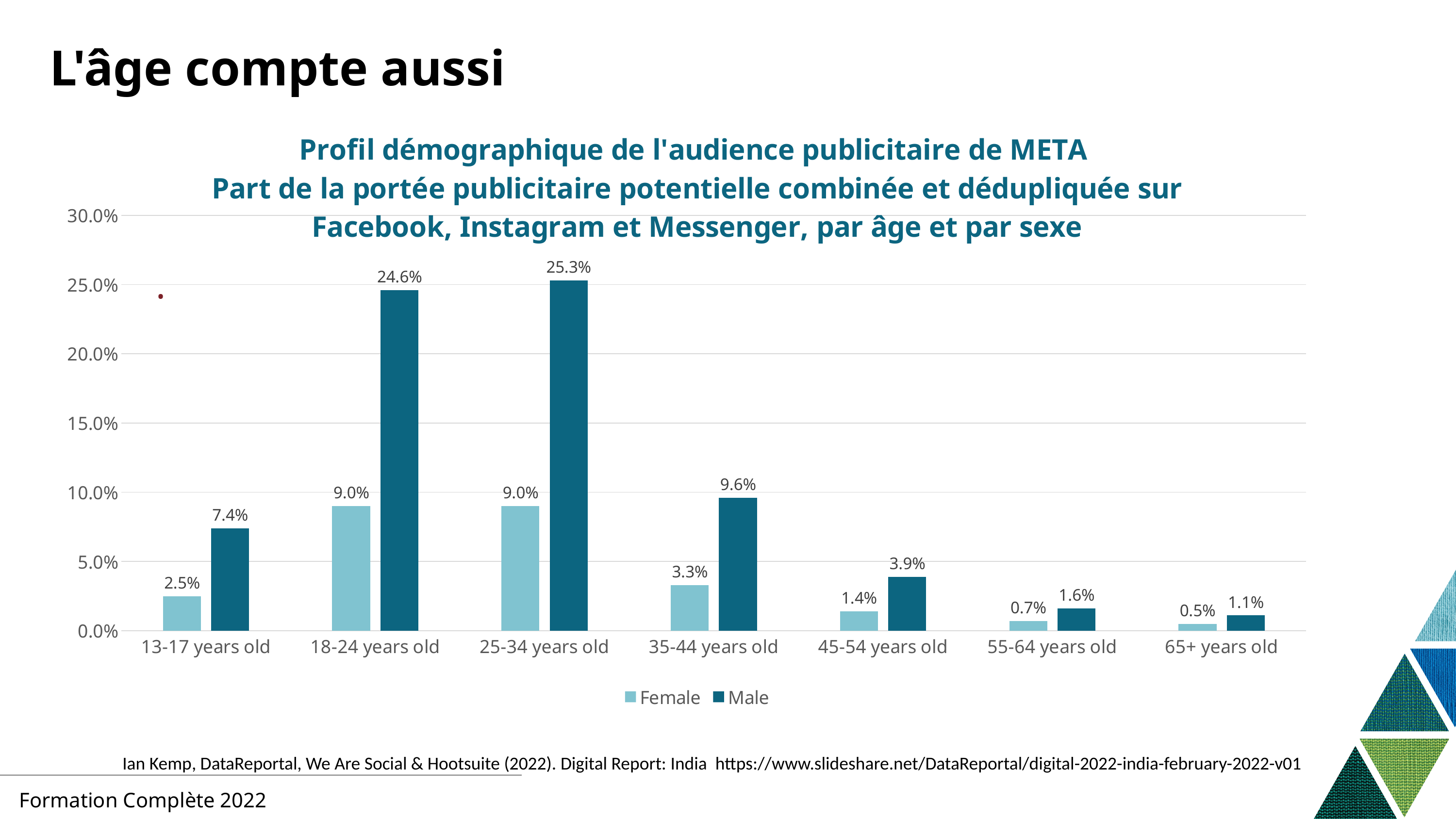
What is the Female value for 35-44 years old? 3.3% What is the Male value for 65+ years old? 1.1% What is the difference between the Male and Female values for 18-24 years old? 15.6% Which age group has the lowest Female value? 65+ years old What kind of chart is shown on the slide? bar chart Do the Female values rise or fall from 25-34 years old to 65+ years old? fall How many series does the legend list? 2 Is the Male value for 18-24 years old greater or less than 20.0%? greater Which is larger, the Male value for 13-17 years old or the Male value for 35-44 years old? 35-44 years old What is the Male value for 25-34 years old? 25.3% Which age group has the highest Male value? 25-34 years old How many age groups are shown on the x axis? 7